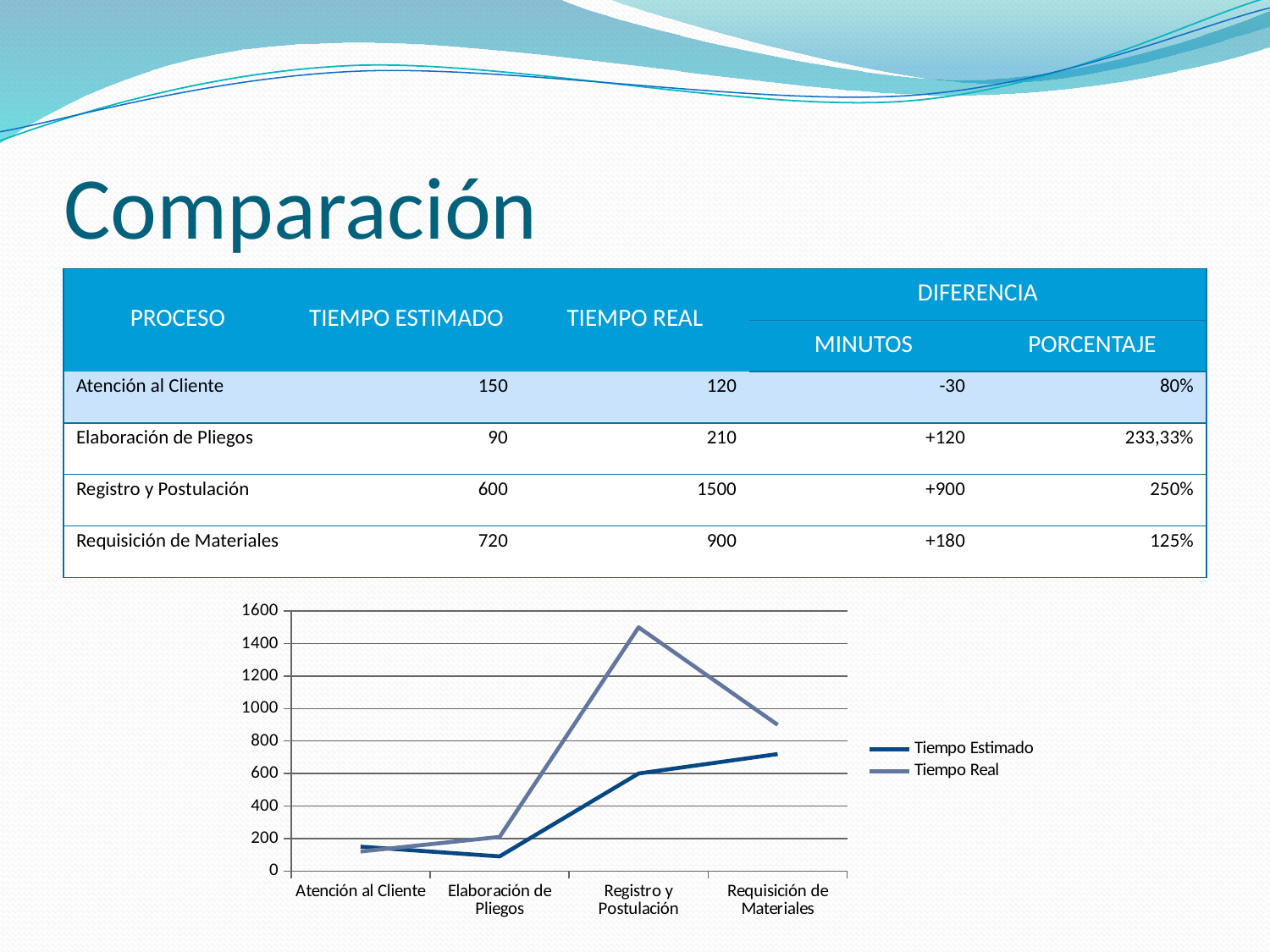
For Atención al Cliente, which is larger: Tiempo Estimado or Tiempo Real? Tiempo Estimado How many series does the chart legend list? 2 How many categories are shown on the x axis of the chart? 4 What is the Tiempo Real value for Registro y Postulación? 1500 Which category has the highest Tiempo Real value? Registro y Postulación What is the difference between Tiempo Real and Tiempo Estimado for Elaboración de Pliegos? 120 Is the Tiempo Real value for Requisición de Materiales greater or less than 800? greater Does the Tiempo Estimado line rise or fall from Elaboración de Pliegos to Requisición de Materiales? rise Which category has the lowest Tiempo Estimado value? Elaboración de Pliegos What kind of chart is shown on the slide? line chart What is the Tiempo Estimado value for Requisición de Materiales? 720 What are the two series named in the chart legend? Tiempo Estimado and Tiempo Real